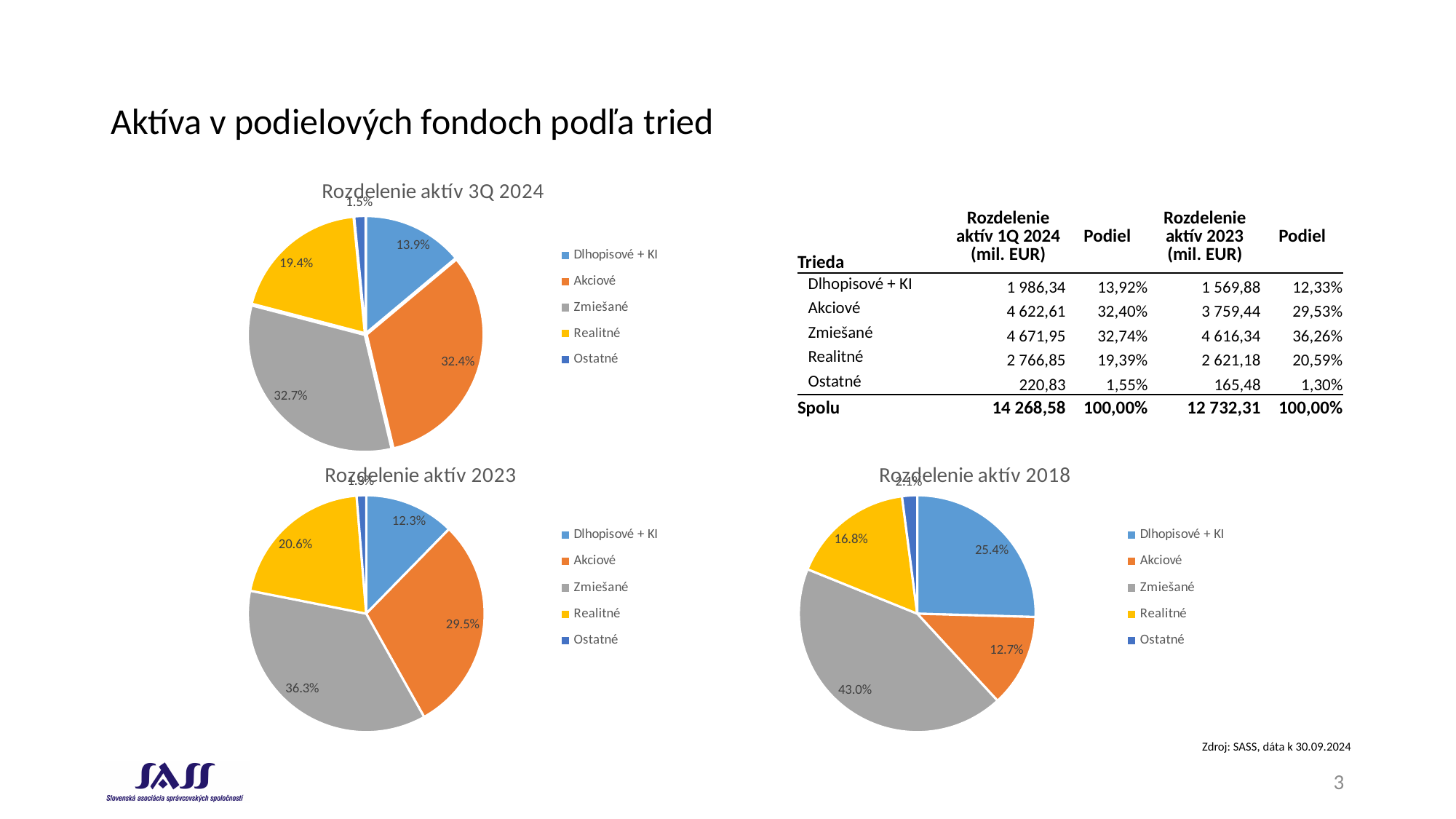
In the 'Rozdelenie aktív 2018' chart, which is larger: Akciové or Realitné? Realitné In the 'Rozdelenie aktív 2023' chart, what share does Zmiešané have? 36.3% In the 'Rozdelenie aktív 2018' chart, what share does Dlhopisové + KI have? 25.4% How many categories does the legend of the 'Rozdelenie aktív 2023' chart list? 5 In the 'Rozdelenie aktív 3Q 2024' chart, which colour represents Realitné? Yellow In the 'Rozdelenie aktív 3Q 2024' chart, what share does Realitné have? 19.4% In the 'Rozdelenie aktív 2023' chart, which category has the smallest share? Ostatné What type of chart is 'Rozdelenie aktív 2018'? Pie chart In the 'Rozdelenie aktív 3Q 2024' chart, what share does Akciové have? 32.4% In the 'Rozdelenie aktív 2018' chart, what is the difference between the Zmiešané share and the Akciové share? 30.3% In the 'Rozdelenie aktív 3Q 2024' chart, what is the difference between the Zmiešané share and the Dlhopisové + KI share? 18.8% In the 'Rozdelenie aktív 2018' chart, which category has the largest share? Zmiešané